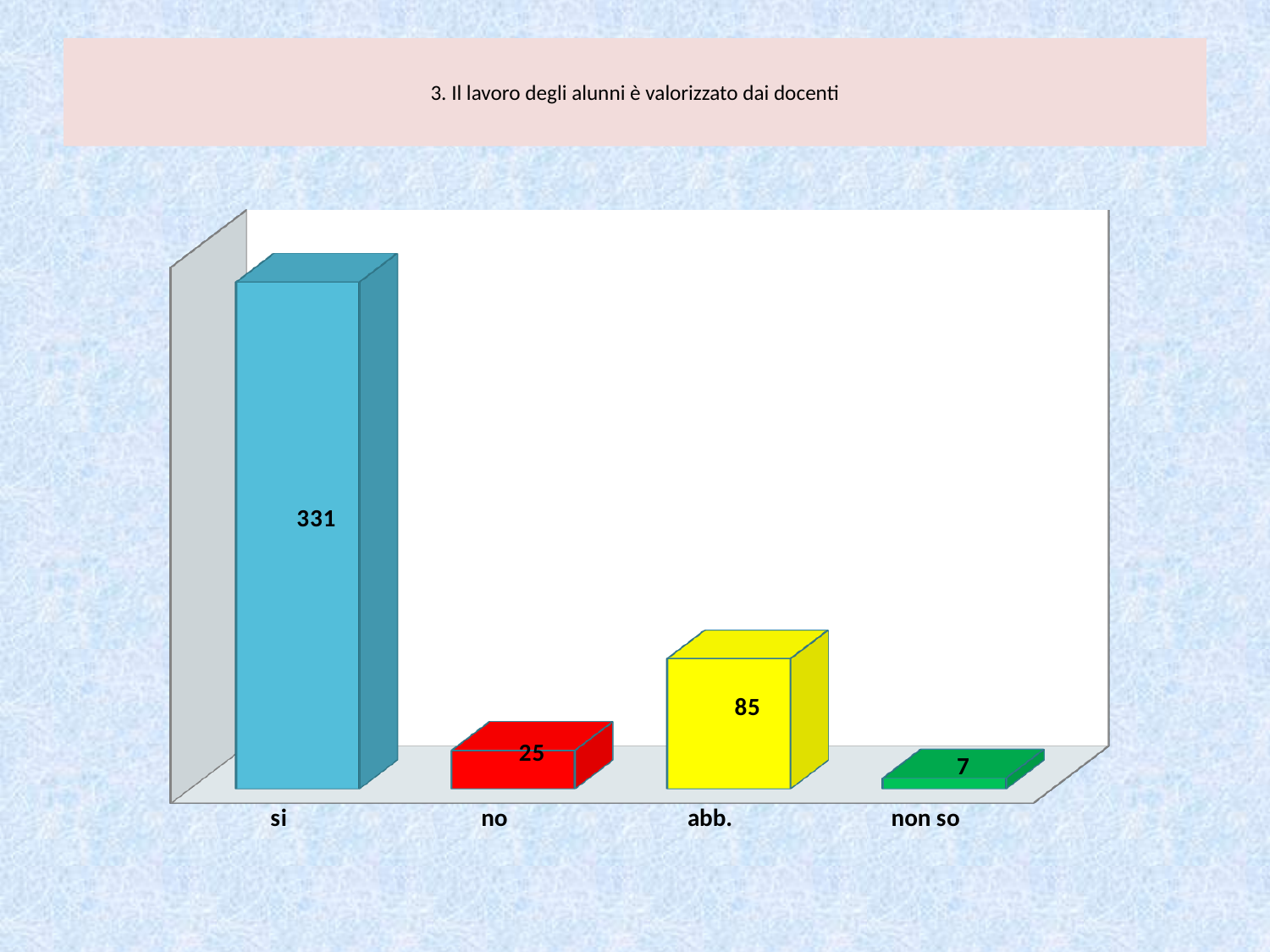
Which category has the lowest value? non so What is the value for "non so"? 7 What is the value for "si"? 331 What is the difference between the values for "no" and "non so"? 18 How many categories are shown on the x axis? 4 What kind of chart is shown on the slide? bar chart What is the value for "abb."? 85 Which category has the highest value? si Which is larger, the value for "no" or the value for "abb."? abb. What is the title of the slide above the chart? 3. Il lavoro degli alunni è valorizzato dai docenti What is the value for "no"? 25 What is the difference between the values for "si" and "abb."? 246